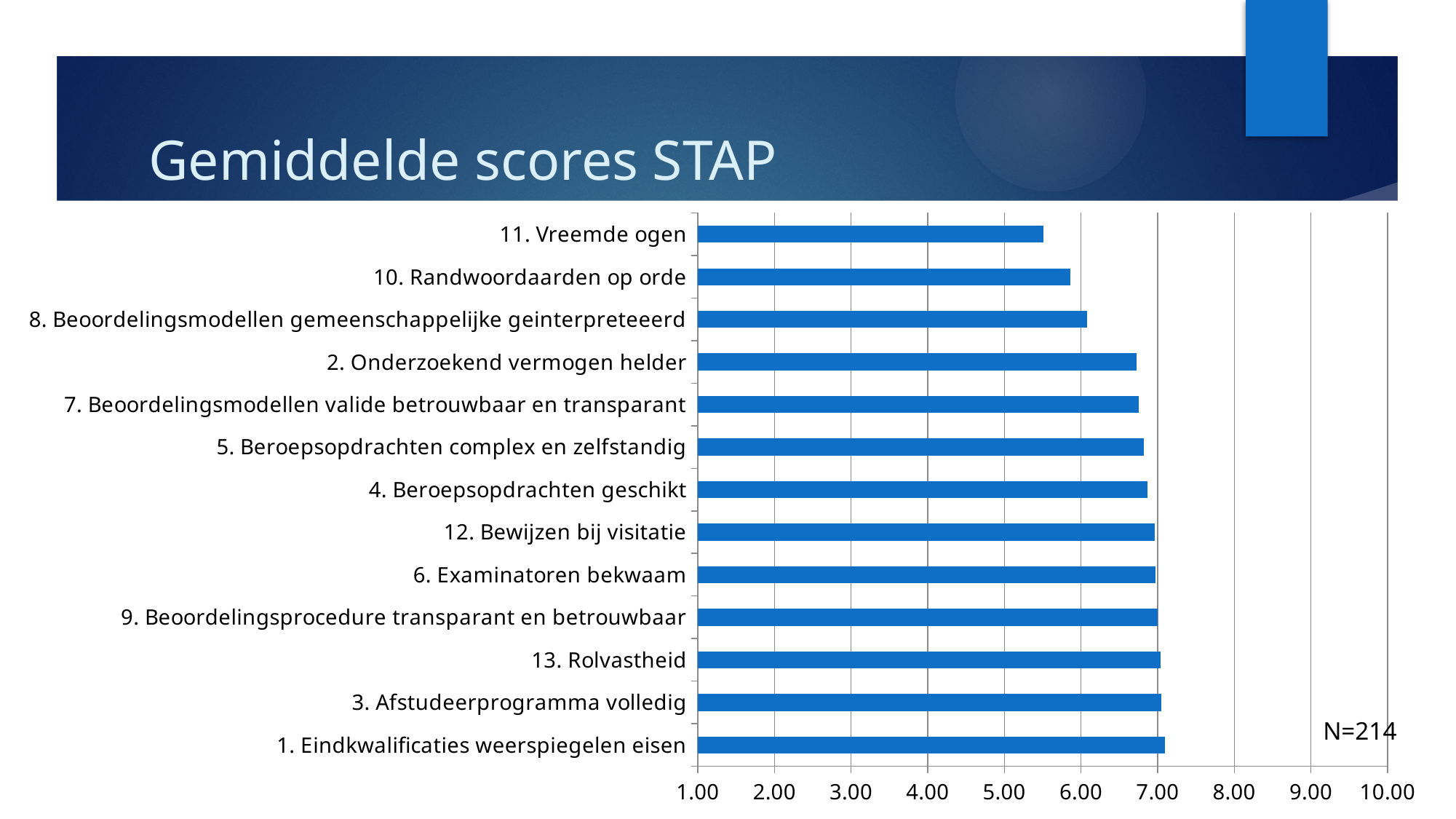
Which has a higher score: 10. Randwoordaarden op orde or 2. Onderzoekend vermogen helder? 2. Onderzoekend vermogen helder Is the value for 13. Rolvastheid greater or less than 6.00? greater What kind of chart is shown on the slide? bar chart How many categories are plotted in the chart? 13 Is the value for 2. Onderzoekend vermogen helder greater or less than 7.00? less Which has a higher score: 8. Beoordelingsmodellen gemeenschappelijke geinterpreteeerd or 4. Beroepsopdrachten geschikt? 4. Beroepsopdrachten geschikt Which category has the lowest score in the chart? 11. Vreemde ogen Which has a higher score: 11. Vreemde ogen or 13. Rolvastheid? 13. Rolvastheid Is the value for 11. Vreemde ogen greater or less than 6.00? less What sample size (N) is noted on the chart? N=214 What is the title of the chart slide? Gemiddelde scores STAP